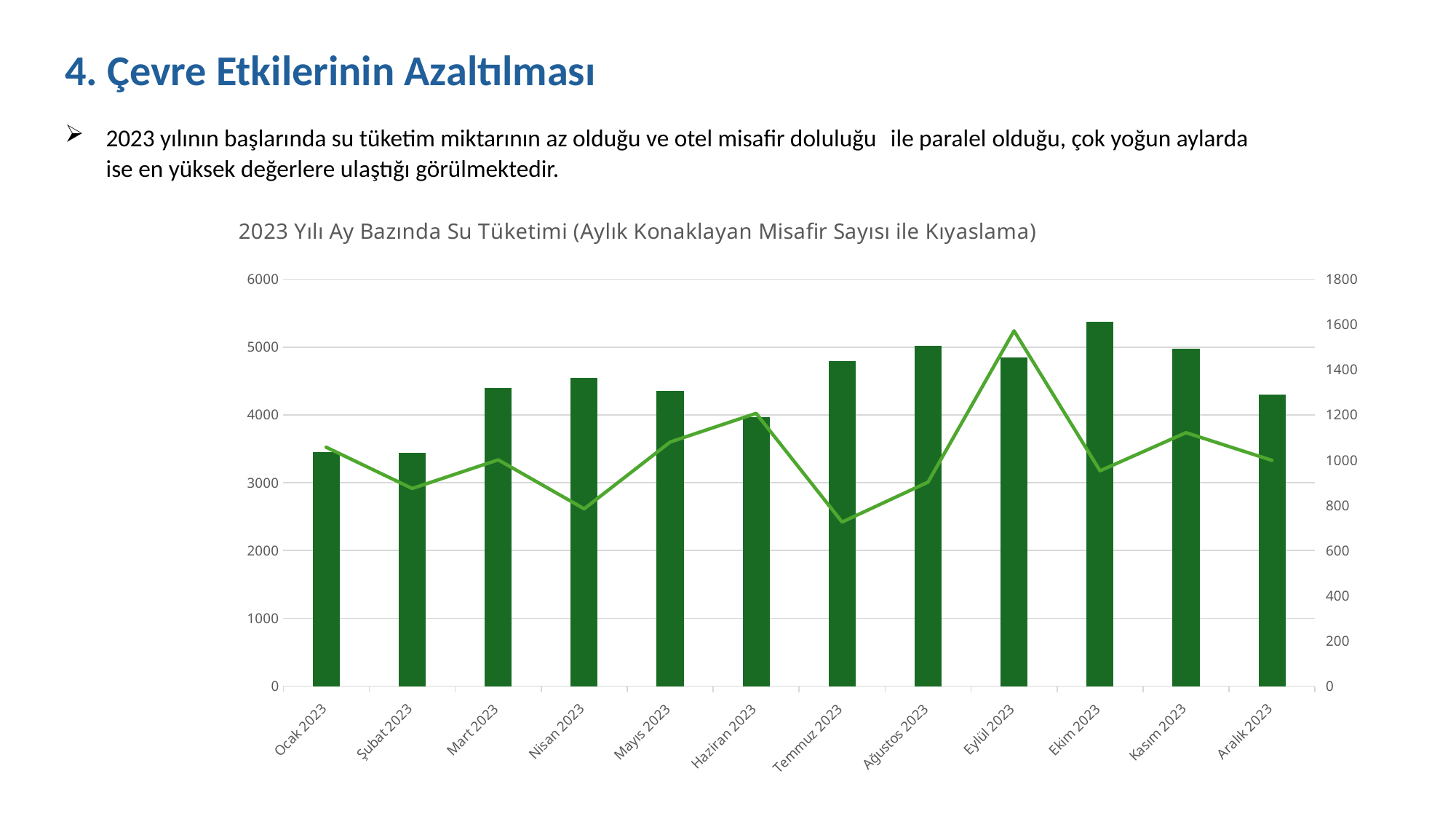
Which month has the tallest bar in the chart? Ekim 2023 Which bar is taller, Mart 2023 or Ağustos 2023? Ağustos 2023 Is the line value for Eylül 2023 on the right axis greater or less than 1400? greater Is the bar value for Ocak 2023 greater or less than 4000? less In which month does the line series reach its lowest point? Temmuz 2023 Is the bar value for Ekim 2023 greater or less than 5000? greater What kind of chart is shown on the slide? A bar chart combined with a line What is the title of the chart? 2023 Yılı Ay Bazında Su Tüketimi (Aylık Konaklayan Misafir Sayısı ile Kıyaslama) How many months are shown on the x axis of the chart? 12 In which month does the line series reach its highest point? Eylül 2023 What is the maximum value shown on the left vertical axis? 6000